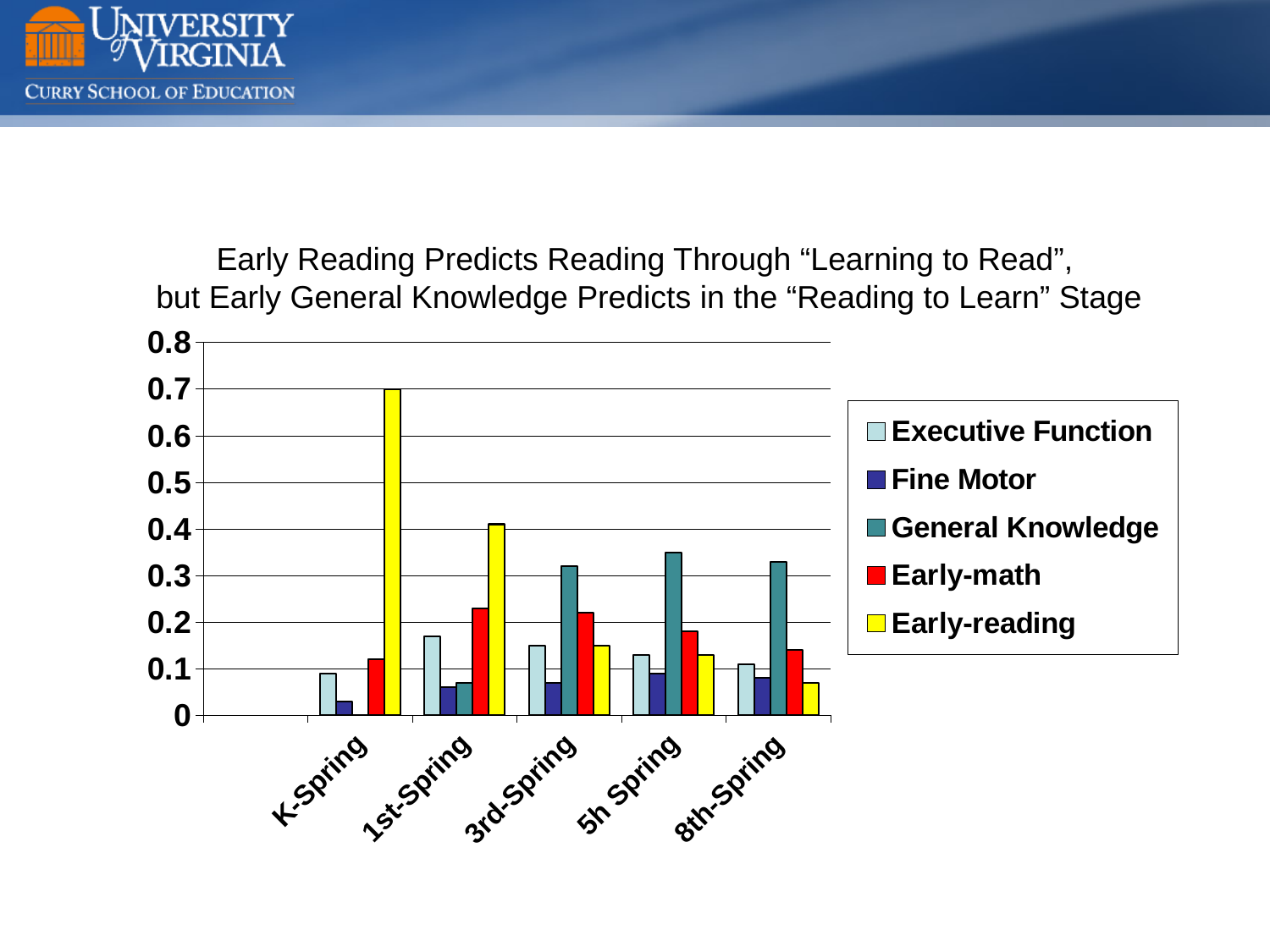
How many categories are shown on the x axis? 5 Do the Early-reading values rise or fall from K-Spring to 8th-Spring? fall How many series does the legend list? 5 What kind of chart is shown on the slide? bar chart At which category is the Early-reading value highest? K-Spring Is the Early-reading value for K-Spring greater or less than 0.6? greater Which series has the lowest value at K-Spring? General Knowledge Is the Fine Motor value for K-Spring greater or less than 0.1? less At 3rd-Spring, which is larger: General Knowledge or Early-reading? General Knowledge Is the General Knowledge value for 5h Spring greater or less than 0.3? greater Which series has the highest value at 8th-Spring? General Knowledge Which series has the highest value at K-Spring? Early-reading